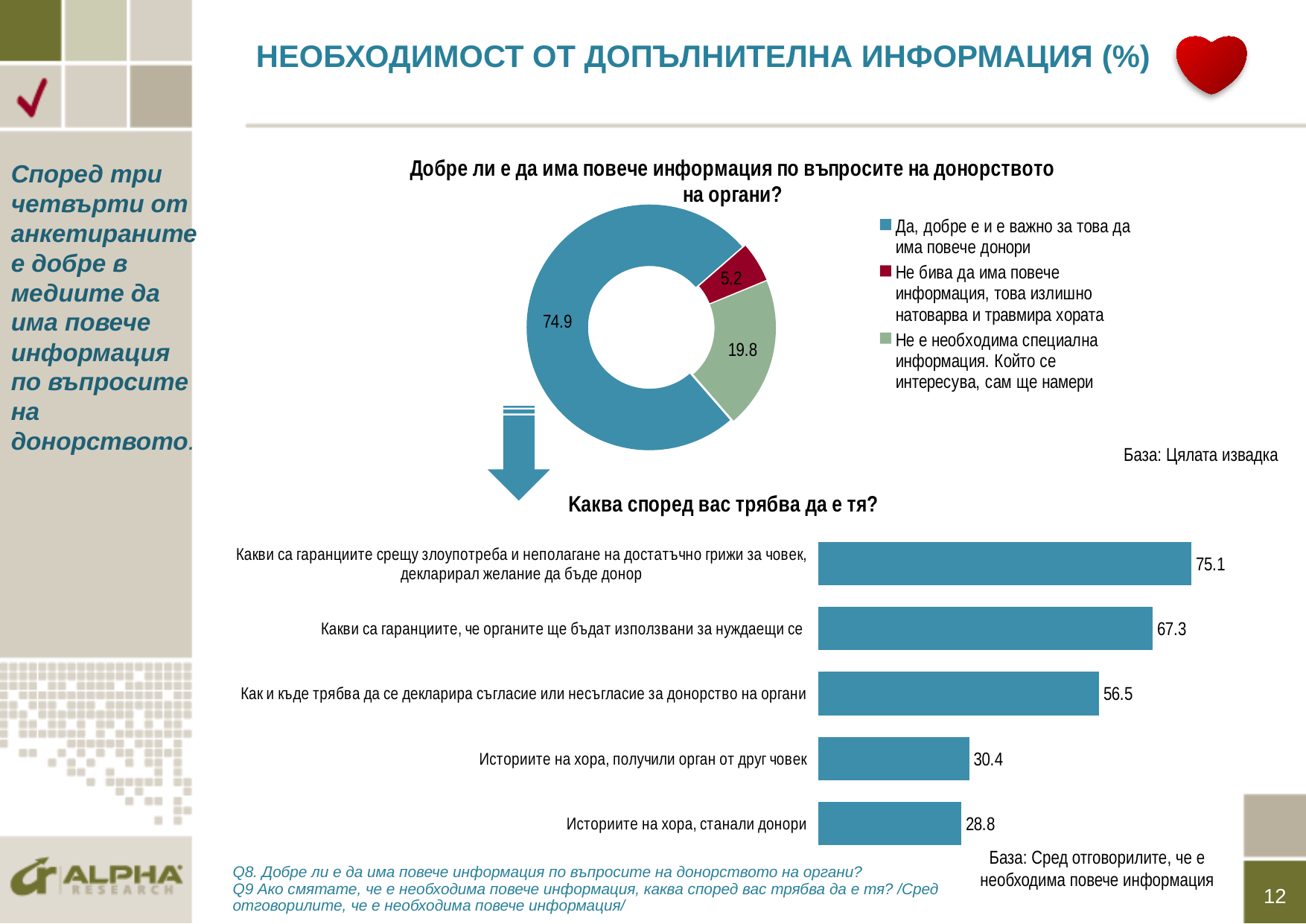
In the bar chart 'Каква според вас трябва да е тя?', how many categories are shown? 5 In the doughnut chart 'Добре ли е да има повече информация по въпросите на донорството на органи?', what is the difference between the values for 'Не е необходима специална информация. Който се интересува, сам ще намери' and 'Не бива да има повече информация, това излишно натоварва и травмира хората'? 14.6 In the doughnut chart 'Добре ли е да има повече информация по въпросите на донорството на органи?', what is the value for 'Да, добре е и е важно за това да има повече донори'? 74.9 In the bar chart 'Каква според вас трябва да е тя?', which category has the lowest value? Историите на хора, станали донори What kind of chart is the top chart 'Добре ли е да има повече информация по въпросите на донорството на органи?'? Doughnut chart What kind of chart is the bottom chart 'Каква според вас трябва да е тя?'? Bar chart In the bar chart 'Каква според вас трябва да е тя?', what is the difference between 'Какви са гаранциите, че органите ще бъдат използвани за нуждаещи се' and 'Как и къде трябва да се декларира съгласие или несъгласие за донорство на органи'? 10.8 In the doughnut chart 'Добре ли е да има повече информация по въпросите на донорството на органи?', how many categories does the legend list? 3 In the doughnut chart 'Добре ли е да има повече информация по въпросите на донорството на органи?', what is the value for 'Не бива да има повече информация, това излишно натоварва и травмира хората'? 5.2 In the bar chart 'Каква според вас трябва да е тя?', what is the value for 'Историите на хора, получили орган от друг човек'? 30.4 In the doughnut chart 'Добре ли е да има повече информация по въпросите на донорството на органи?', which category has the smallest share? Не бива да има повече информация, това излишно натоварва и травмира хората In the bar chart 'Каква според вас трябва да е тя?', which category has the highest value? Какви са гаранциите срещу злоупотреба и неполагане на достатъчно грижи за човек, декларирал желание да бъде донор